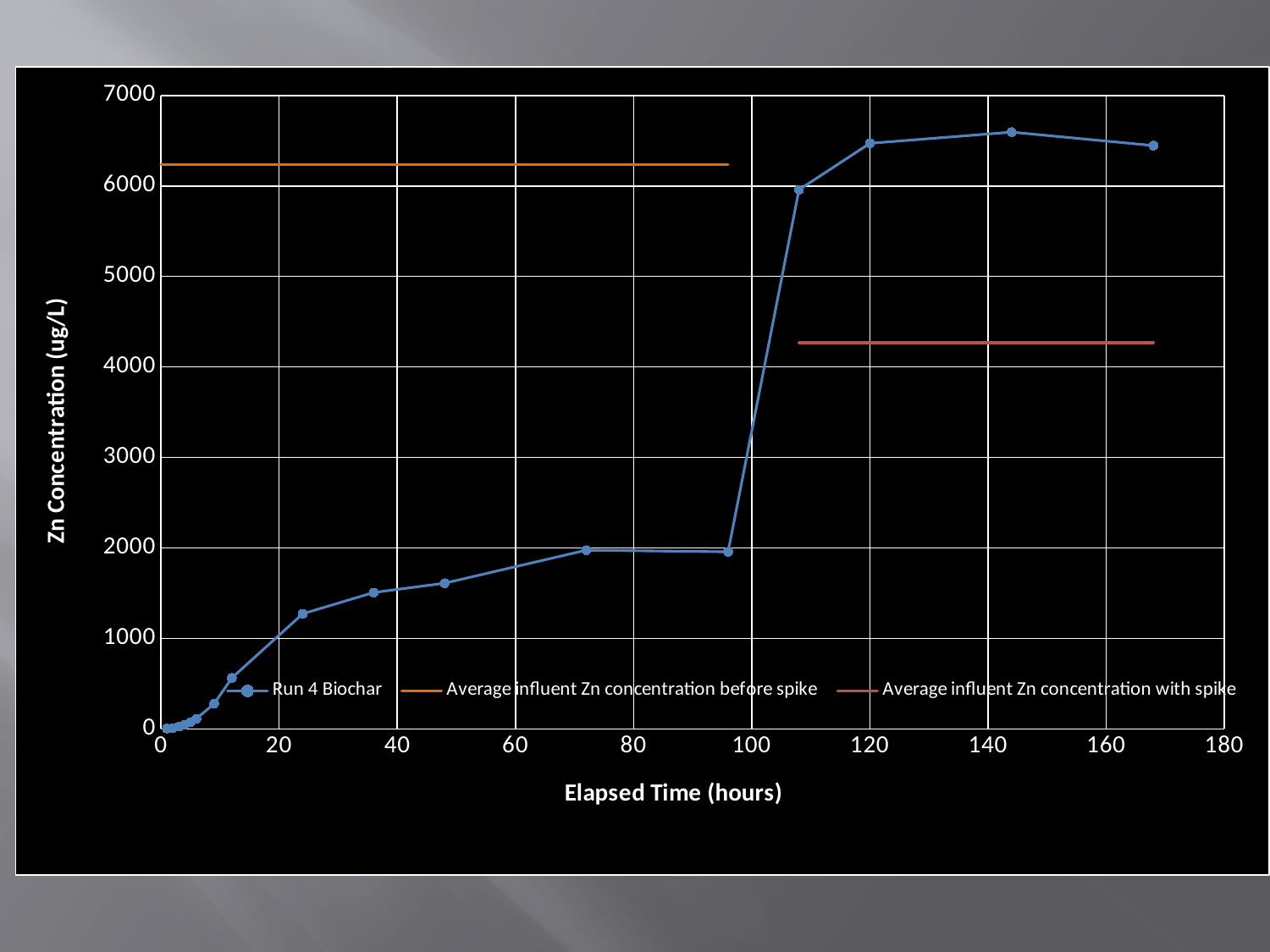
Is the Run 4 Biochar value at 24 hours greater or less than 1000? greater What kind of chart is shown on the slide? line chart Which is larger for Run 4 Biochar: the value at 96 hours or the value at 108 hours? 108 hours Is the Run 4 Biochar value at 48 hours greater or less than 2000? less Which line is higher: Average influent Zn concentration before spike or Average influent Zn concentration with spike? Average influent Zn concentration before spike Is the Average influent Zn concentration before spike line greater or less than 6000? greater How many series does the legend list? 3 What is the title of the y axis? Zn Concentration (ug/L) Does the Run 4 Biochar series generally rise or fall as elapsed time increases? rise What is the title of the x axis? Elapsed Time (hours)